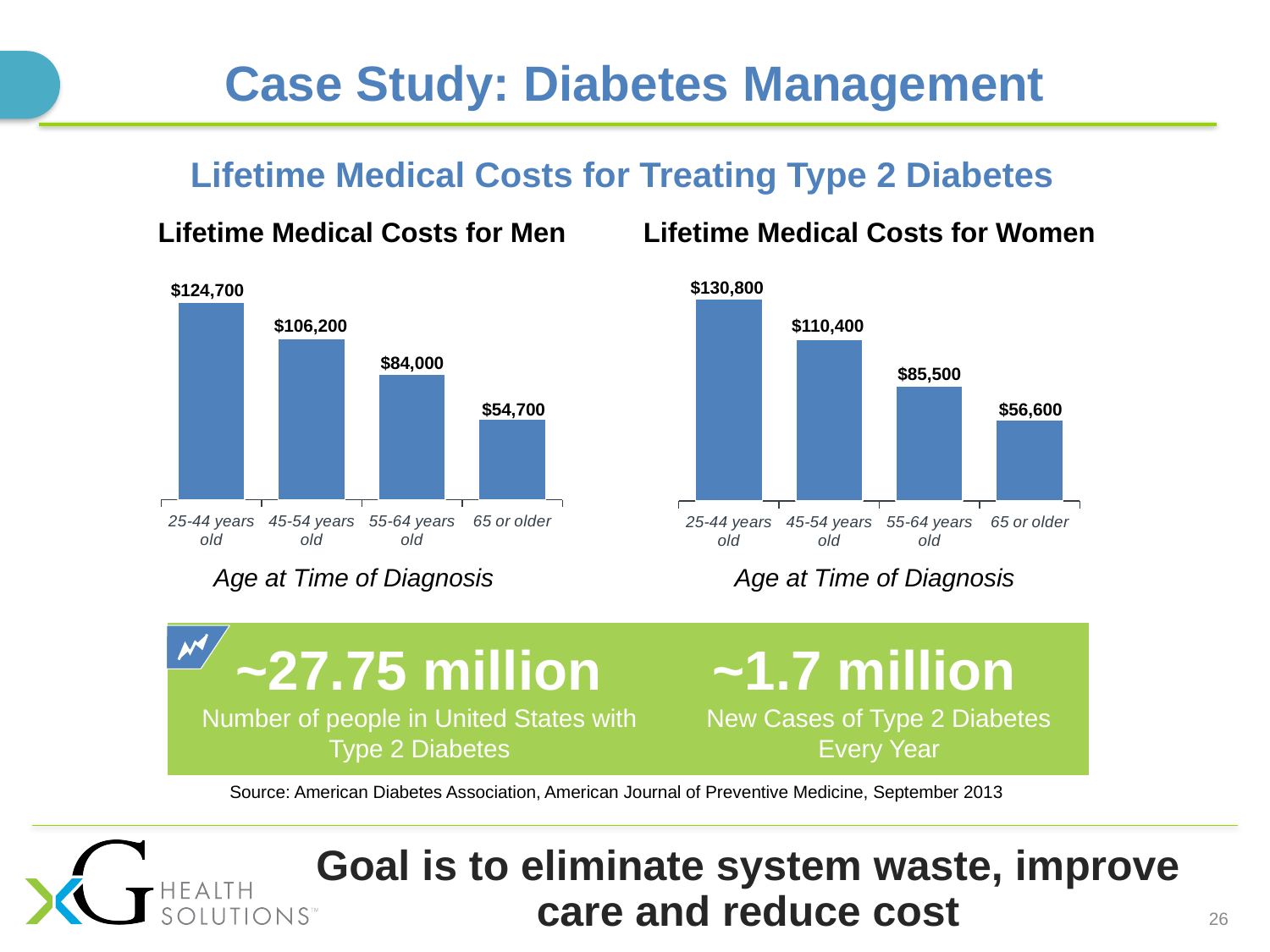
How many age categories are shown in the 'Lifetime Medical Costs for Men' chart? 4 Which is larger: the value for 45-54 years old in the 'Lifetime Medical Costs for Men' chart or the value for 45-54 years old in the 'Lifetime Medical Costs for Women' chart? Women ($110,400) In the 'Lifetime Medical Costs for Women' chart, which age group has the highest lifetime medical cost? 25-44 years old In the 'Lifetime Medical Costs for Men' chart, what is the value for 65 or older? $54,700 In the 'Lifetime Medical Costs for Men' chart, which age group has the lowest lifetime medical cost? 65 or older In the 'Lifetime Medical Costs for Men' chart, what is the value for 25-44 years old? $124,700 In the 'Lifetime Medical Costs for Men' chart, what is the difference between the values for 55-64 years old and 65 or older? $29,300 In the 'Lifetime Medical Costs for Women' chart, what is the value for 55-64 years old? $85,500 In the 'Lifetime Medical Costs for Women' chart, what is the difference between the values for 25-44 years old and 45-54 years old? $20,400 In the 'Lifetime Medical Costs for Men' chart, do the values rise or fall as age at diagnosis increases? Fall What kind of chart is the 'Lifetime Medical Costs for Women' chart? Bar chart What is the x-axis label of the 'Lifetime Medical Costs for Women' chart? Age at Time of Diagnosis